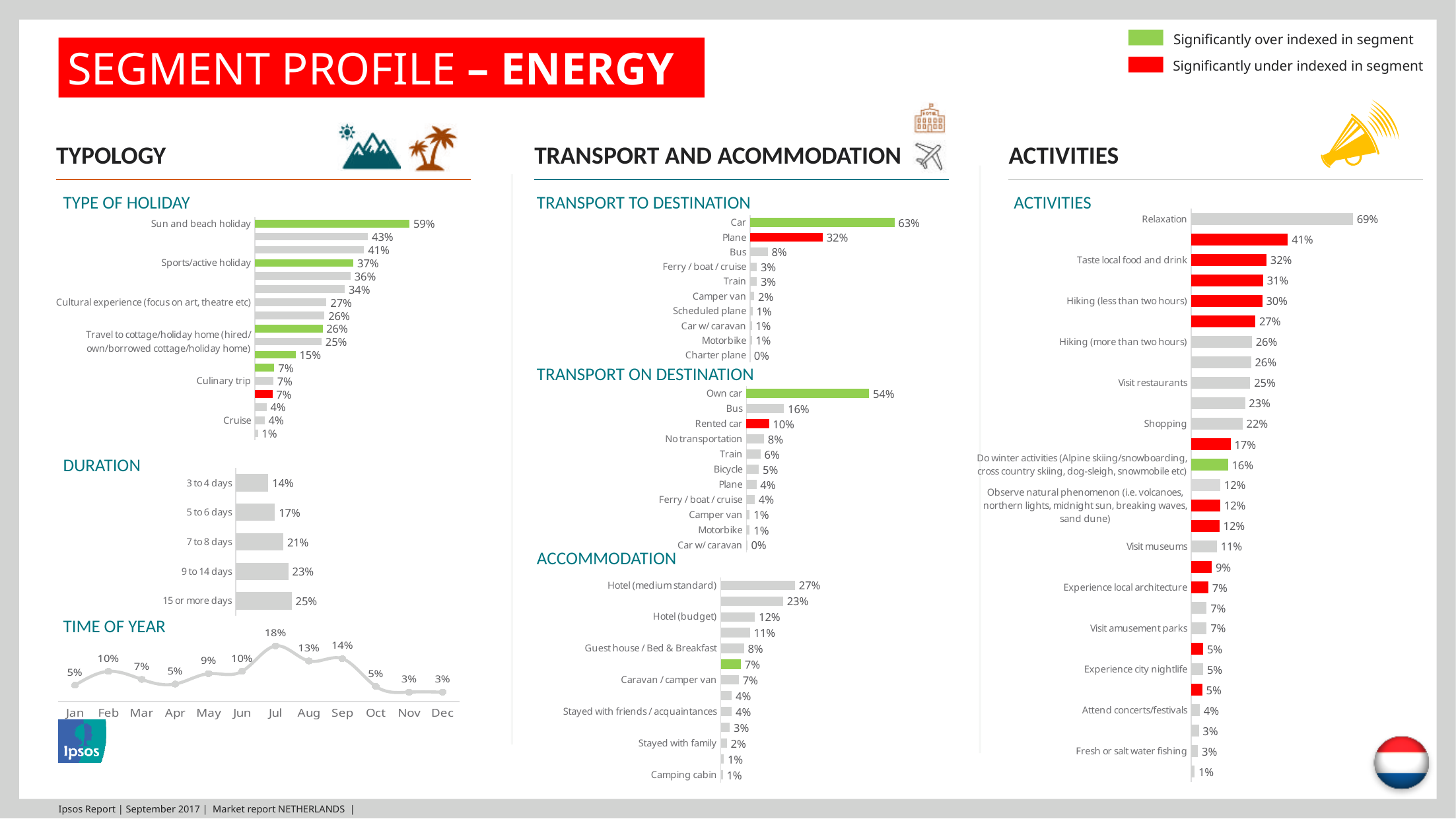
In the Time of Year chart, which month has the highest value? Jul In the Time of Year chart, what is the value for Sep? 14% In the Activities chart, what is the value for Relaxation? 69% In the Duration chart, what is the value for 15 or more days? 25% In the Time of Year chart, what kind of chart is used? line chart In the Type of Holiday chart, what is the value for the first bar of Sun and beach holiday? 59% In the Transport to Destination chart, what is the difference between Car and Plane? 31% How many categories are shown in the Duration chart? 5 In the Transport to Destination chart, what is the value for Plane? 32% In the Transport on Destination chart, which is larger, Bus or Rented car? Bus In the Duration chart, do the values rise or fall as the duration increases from 3 to 4 days to 15 or more days? rise In the Transport on Destination chart, which category has the highest value? Own car